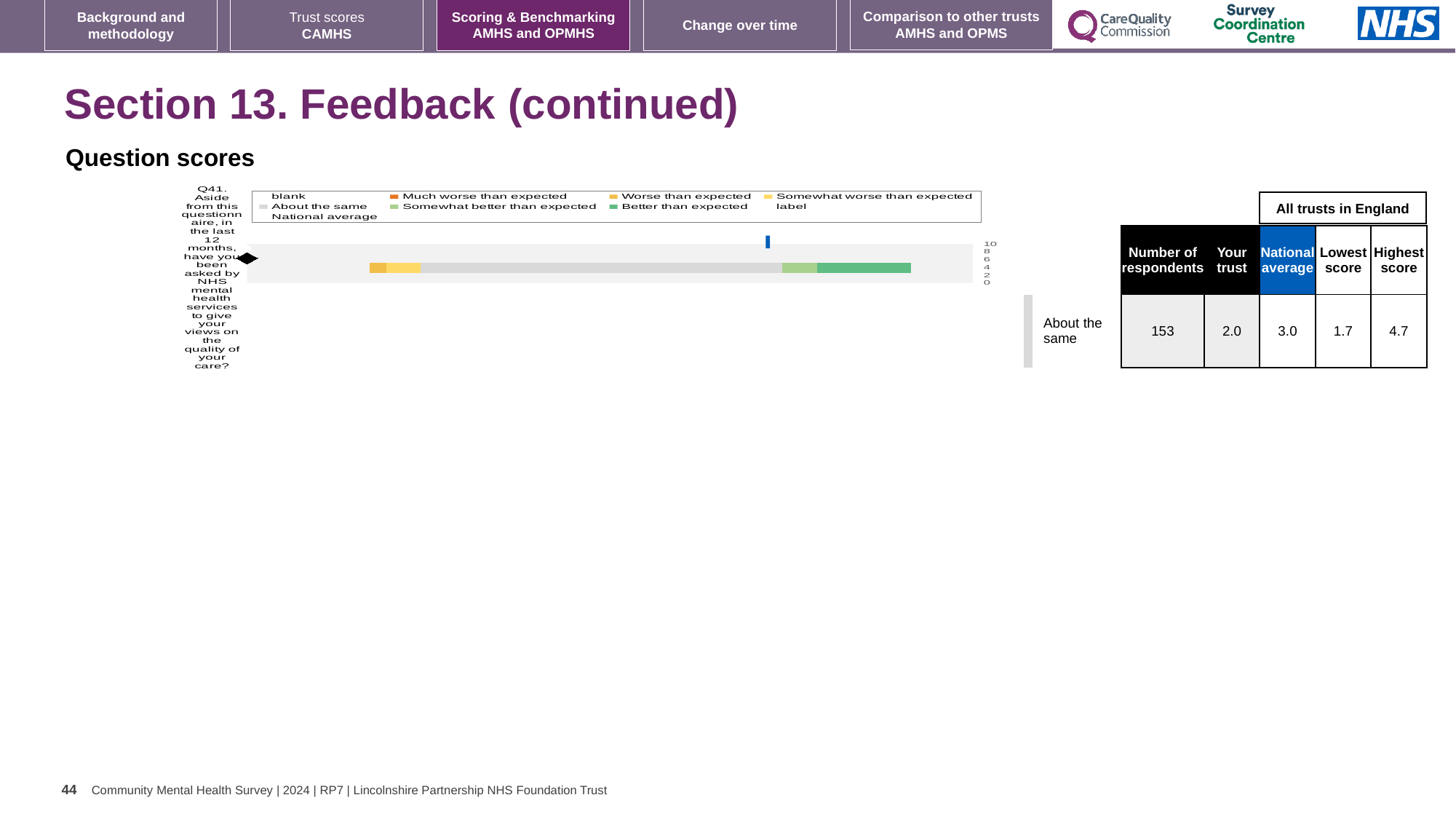
How many survey questions are plotted in the chart? 1 What is the 'Your trust' score for Q41? 2.0 What is the difference between the highest and lowest scores for Q41? 3.0 How many entries does the chart legend list? 9 Which benchmark category is the trust's score for Q41 placed in? About the same What kind of chart is shown on the slide? bar chart Which question number is plotted in the chart? Q41 What is the lowest score among all trusts in England for Q41? 1.7 Which is larger for Q41, the trust's score or the national average? National average How many respondents answered Q41? 153 What is the national average score for Q41? 3.0 What is the highest score among all trusts in England for Q41? 4.7